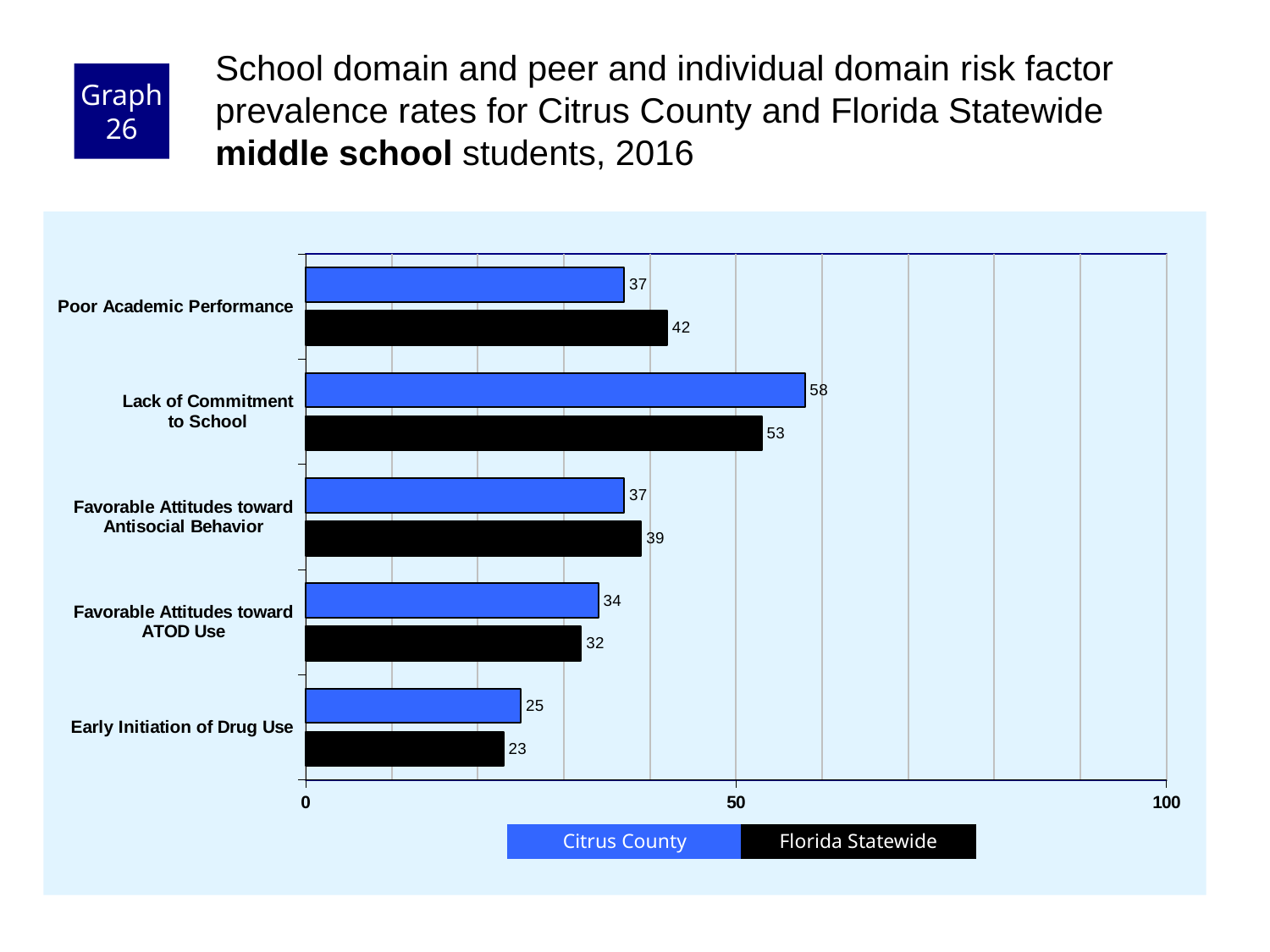
What kind of chart is shown on the slide? bar chart Which risk factor has the lowest Florida Statewide value? Early Initiation of Drug Use How many risk factor categories are shown on the chart? 5 Is the Citrus County value for Lack of Commitment to School greater or less than 50? greater What is the Florida Statewide value for Early Initiation of Drug Use? 23 What is the Florida Statewide value for Poor Academic Performance? 42 Which risk factor has the highest Citrus County value? Lack of Commitment to School What is the difference between the Florida Statewide and Citrus County values for Poor Academic Performance? 5 What is the difference between the Citrus County and Florida Statewide values for Lack of Commitment to School? 5 For Favorable Attitudes toward ATOD Use, which is larger: the Citrus County value or the Florida Statewide value? Citrus County How many series does the legend list? 2 What is the Citrus County value for Lack of Commitment to School? 58